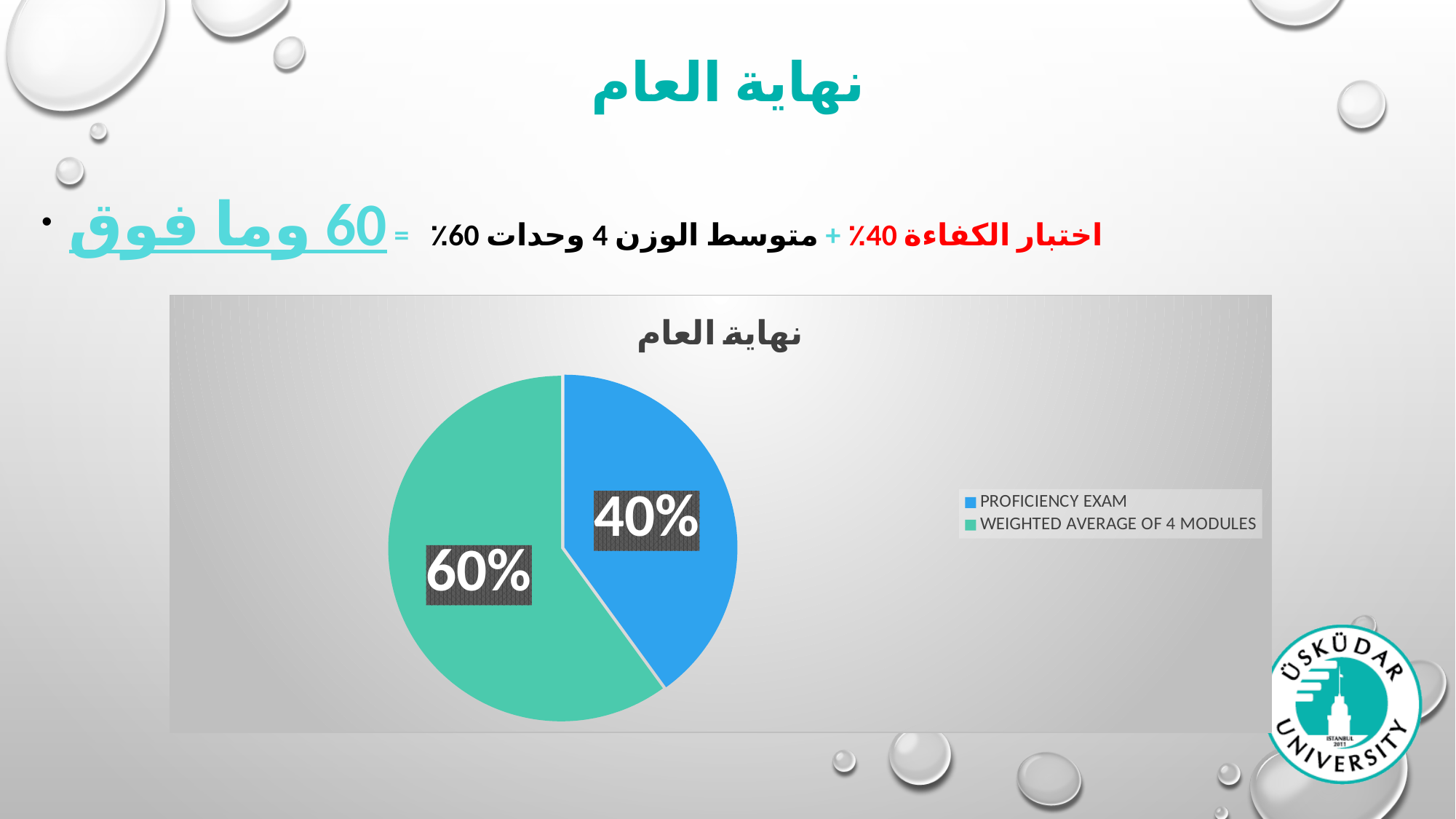
What colour is the PROFICIENCY EXAM slice? blue What is the title of the chart? نهاية العام What kind of chart is shown on the slide? pie chart What is the value for PROFICIENCY EXAM? 40% What is the difference between the WEIGHTED AVERAGE OF 4 MODULES slice and the PROFICIENCY EXAM slice? 20% What share of the pie does the PROFICIENCY EXAM slice represent? 40% What is the value for WEIGHTED AVERAGE OF 4 MODULES? 60% Which slice is the smallest? PROFICIENCY EXAM Which slice is the largest? WEIGHTED AVERAGE OF 4 MODULES How many entries does the legend list? 2 Which is larger, PROFICIENCY EXAM or WEIGHTED AVERAGE OF 4 MODULES? WEIGHTED AVERAGE OF 4 MODULES How many slices does the pie chart have? 2